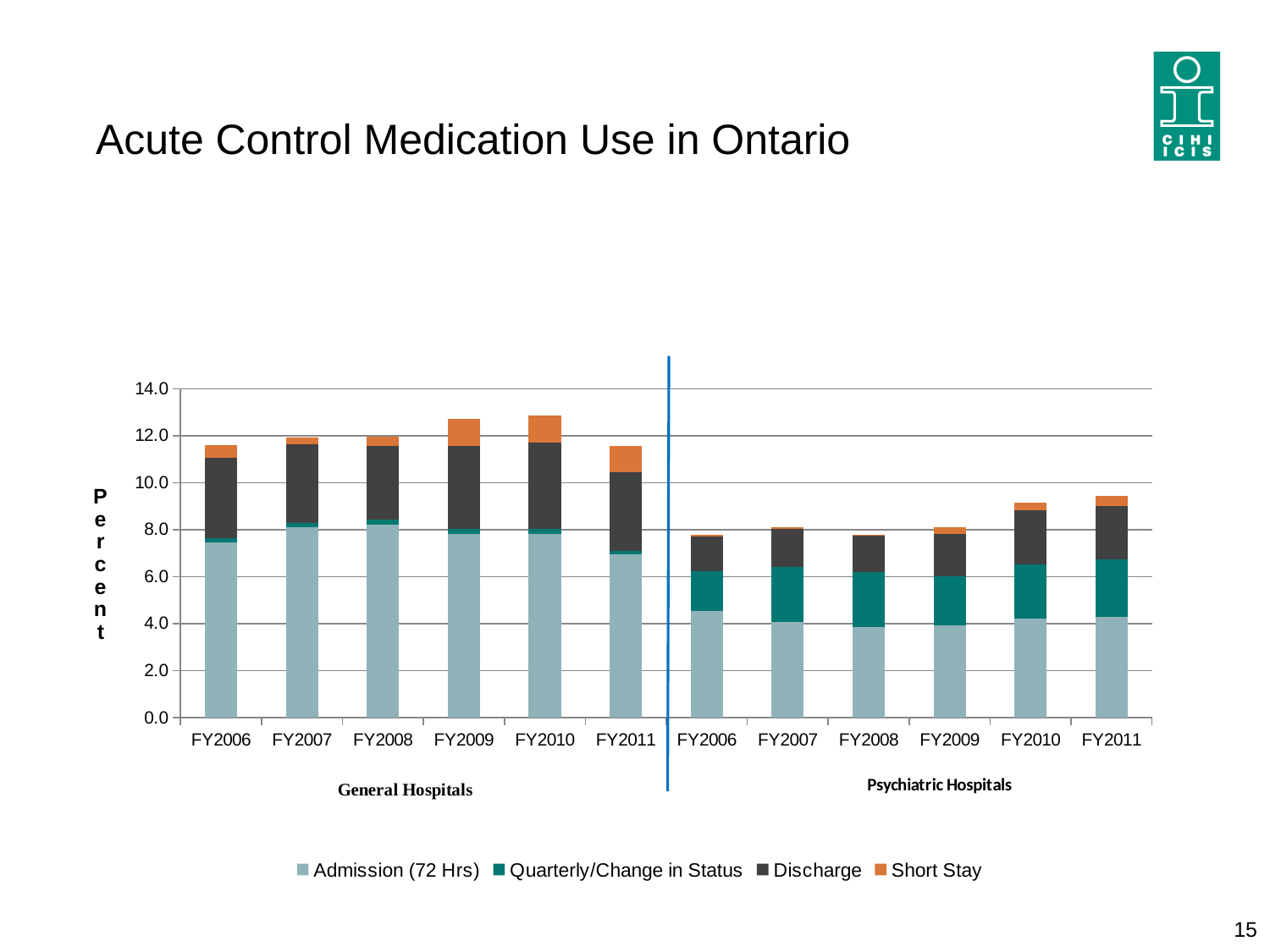
Is the Admission (72 Hrs) value for General Hospitals in FY2006 greater or less than 8.0? less Is the total for General Hospitals in FY2011 greater or less than 12.0? less Among the Psychiatric Hospitals bars, which fiscal year has the highest total? FY2011 How many series does the legend list? 4 What kind of chart is shown on the slide? Stacked bar chart Is the total for Psychiatric Hospitals in FY2011 greater or less than 8.0? greater How many fiscal years are shown for Psychiatric Hospitals? 6 What is the label on the vertical axis? Percent Do the Psychiatric Hospitals totals generally rise or fall from FY2006 to FY2011? rise How many bars are plotted in the chart in total? 12 Which is larger, the total bar for General Hospitals in FY2010 or the total bar for Psychiatric Hospitals in FY2010? General Hospitals FY2010